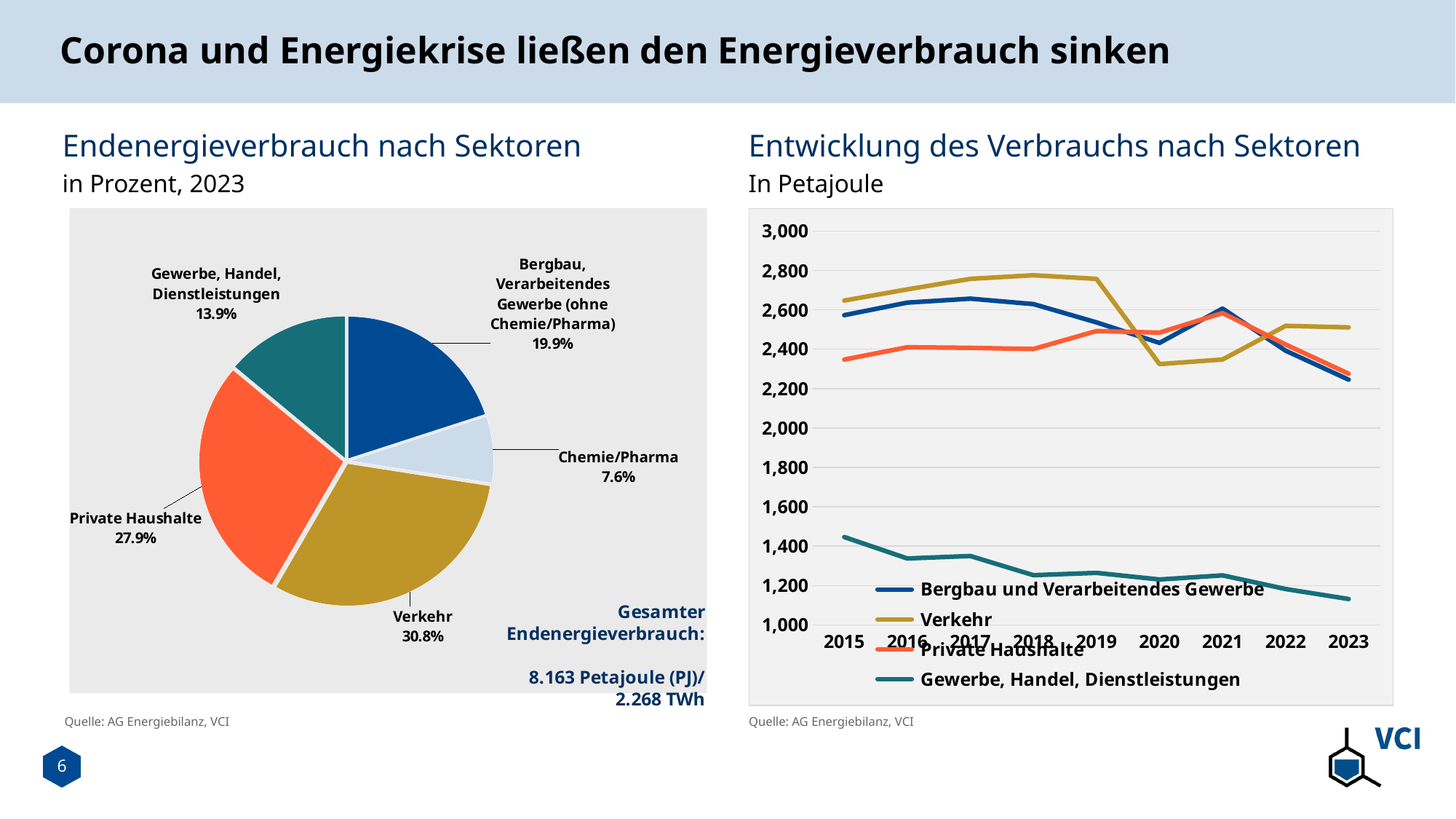
What type of chart is 'Entwicklung des Verbrauchs nach Sektoren'? Line chart In the chart 'Entwicklung des Verbrauchs nach Sektoren', does the Gewerbe, Handel, Dienstleistungen line rise or fall from 2015 to 2023? fall In the chart 'Entwicklung des Verbrauchs nach Sektoren', is the value for Bergbau und Verarbeitendes Gewerbe in 2023 greater or less than 2,400? less How many series does the legend of the chart 'Entwicklung des Verbrauchs nach Sektoren' list? 4 In the chart 'Entwicklung des Verbrauchs nach Sektoren', is the value for Gewerbe, Handel, Dienstleistungen in 2015 greater or less than 1,400? greater In the pie chart 'Endenergieverbrauch nach Sektoren', which sector has the largest share? Verkehr In the pie chart 'Endenergieverbrauch nach Sektoren', which is larger: Bergbau, Verarbeitendes Gewerbe (ohne Chemie/Pharma) or Gewerbe, Handel, Dienstleistungen? Bergbau, Verarbeitendes Gewerbe (ohne Chemie/Pharma) In the pie chart 'Endenergieverbrauch nach Sektoren', what share does Chemie/Pharma have? 7.6% In the pie chart 'Endenergieverbrauch nach Sektoren', how many percentage points larger is Verkehr than Private Haushalte? 2.9 In the pie chart 'Endenergieverbrauch nach Sektoren', which sector has the smallest share? Chemie/Pharma In the pie chart 'Endenergieverbrauch nach Sektoren', what share does Verkehr have? 30.8% How many slices does the pie chart 'Endenergieverbrauch nach Sektoren' have? 5